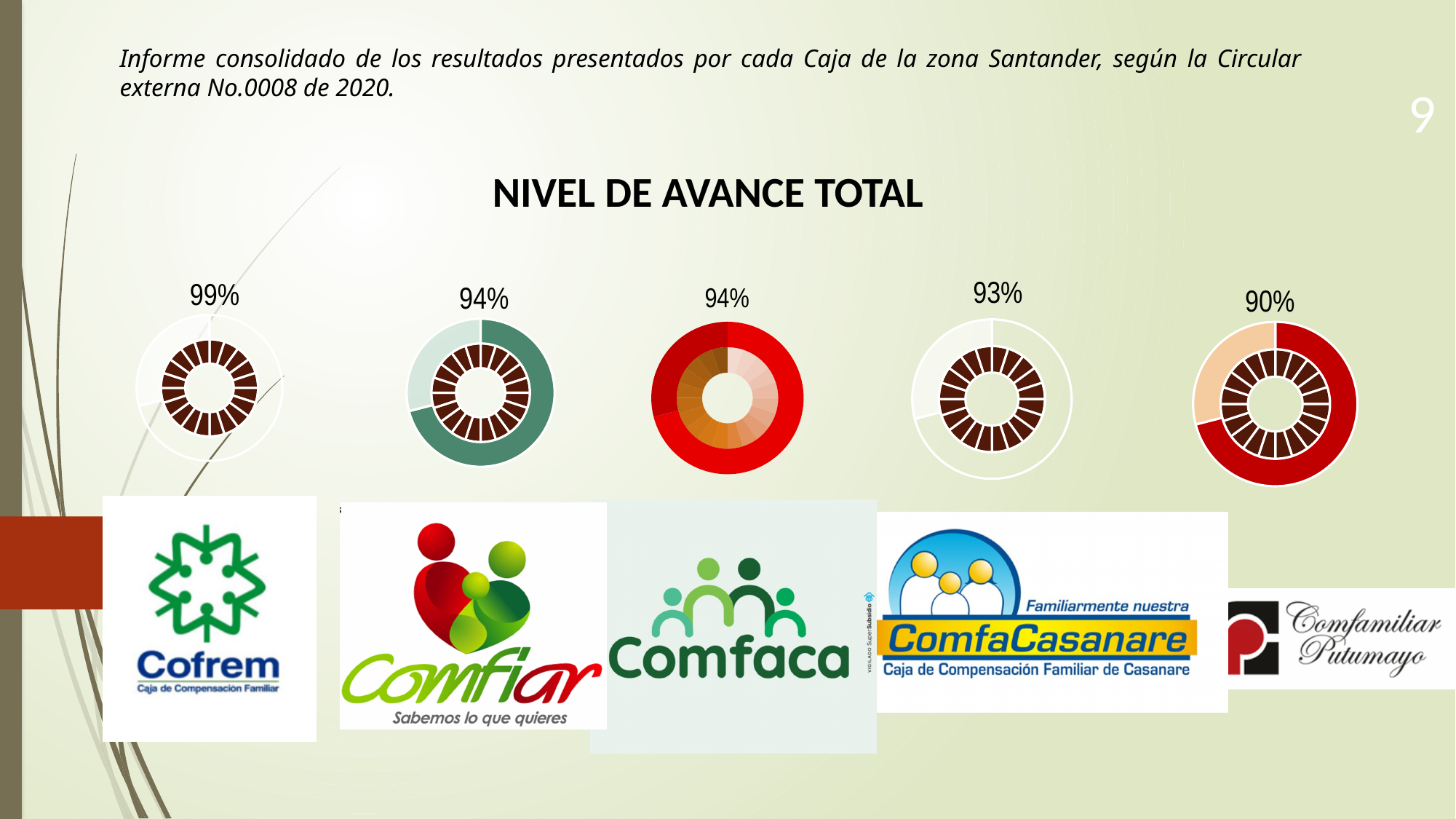
How many Cajas have their nivel de avance total shown on the slide? 5 Which has a higher nivel de avance total, ComfaCasanare or Comfiar? Comfiar What is the nivel de avance total shown for Comfamiliar Putumayo? 90% What kind of chart is used to show each Caja's nivel de avance total? Donut chart What is the nivel de avance total shown for ComfaCasanare? 93% What is the nivel de avance total shown for Cofrem? 99% What is the nivel de avance total shown for Comfiar? 94% What is the nivel de avance total shown for Comfaca? 94% Which Caja has the highest nivel de avance total on the slide? Cofrem What is the difference between the nivel de avance total of Cofrem and Comfamiliar Putumayo? 9% What is the title above the charts on the slide? NIVEL DE AVANCE TOTAL Which Caja has the lowest nivel de avance total on the slide? Comfamiliar Putumayo